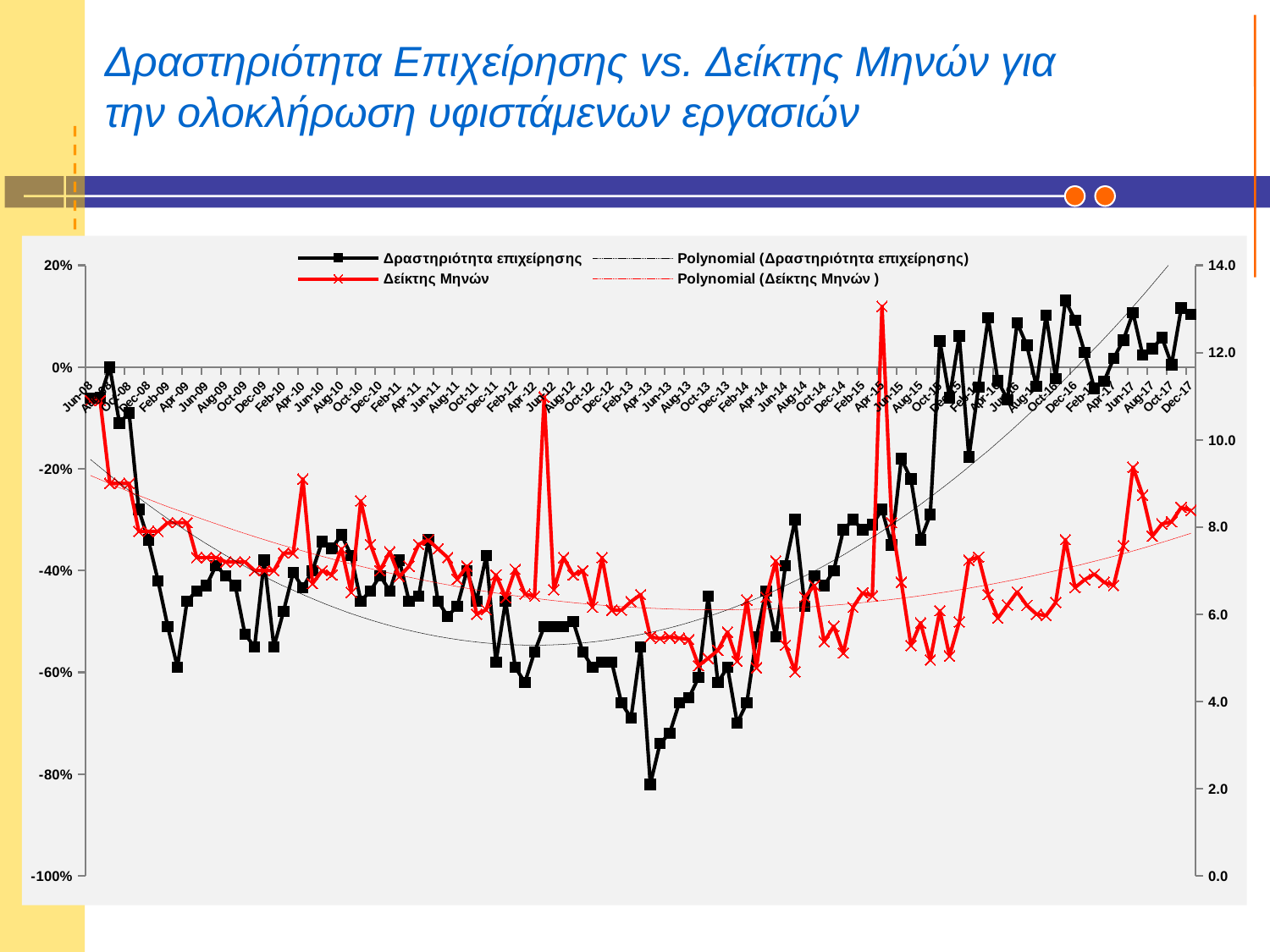
What kind of chart is shown on the slide? line chart Is the value for Δραστηριότητα επιχείρησης higher in Dec-17 or in Jun-08? Dec-17 How many entries does the chart legend list? 4 Does Δραστηριότητα επιχείρησης generally rise or fall between Jun-08 and Apr-09? fall What is the highest value shown on the right vertical axis? 14.0 Does Δραστηριότητα επιχείρησης generally rise or fall between Apr-13 and Dec-17? rise Is the value for Δραστηριότητα επιχείρησης in Apr-09 greater or less than -40%? less Is the value for Δείκτης Μηνών in Dec-17 greater or less than 6.0? greater Is the value for Δείκτης Μηνών in Apr-15 greater or less than 12.0? greater Which series is plotted in red with X markers? Δείκτης Μηνών